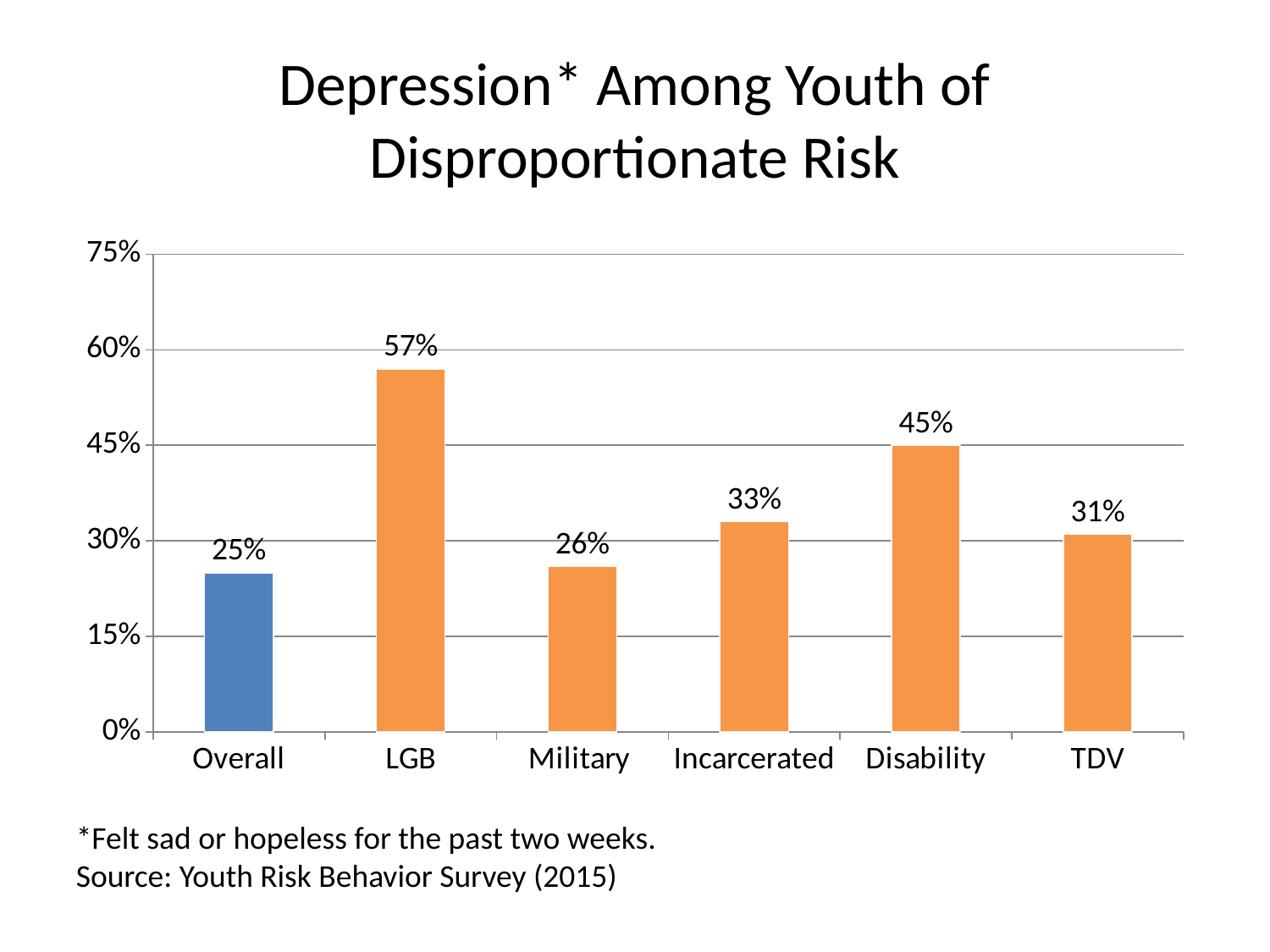
What is the title of the chart? Depression* Among Youth of Disproportionate Risk What is the value for Overall? 25% What is the difference between the values for LGB and Overall? 32% Which category has the lowest value? Overall What is the value for Disability? 45% Which is larger, the value for Military or the value for TDV? TDV Which category has the highest value? LGB What is the value for LGB? 57% What kind of chart is shown on the slide? Bar chart What is the value for TDV? 31% What is the difference between the values for Disability and Incarcerated? 12% How many categories are shown on the x axis? 6